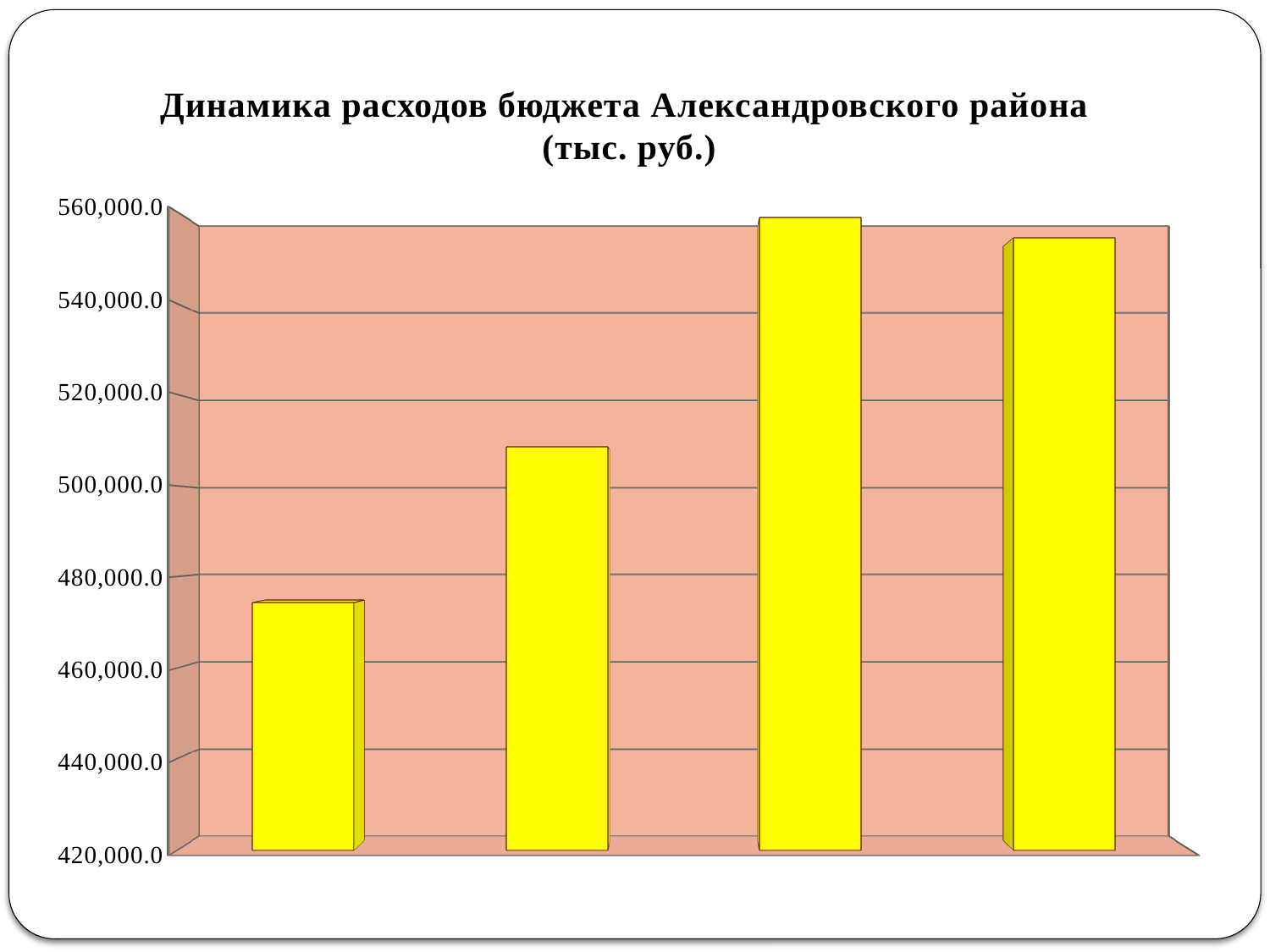
How many bars are plotted in the chart? 4 Which bar is the lowest in the chart? the first (leftmost) bar Is the value of the fourth (rightmost) bar greater or less than 540,000.0? greater Which is larger, the first bar or the second bar? the second bar What is the title of the chart? Динамика расходов бюджета Александровского района (тыс. руб.) Is the value of the first (leftmost) bar greater or less than 480,000.0? less What kind of chart is shown on the slide? bar chart From the first bar to the third bar, do the values rise or fall? rise What unit is given in the chart title? тыс. руб. Which is larger, the second bar or the third bar? the third bar Is the value of the third bar greater or less than 540,000.0? greater